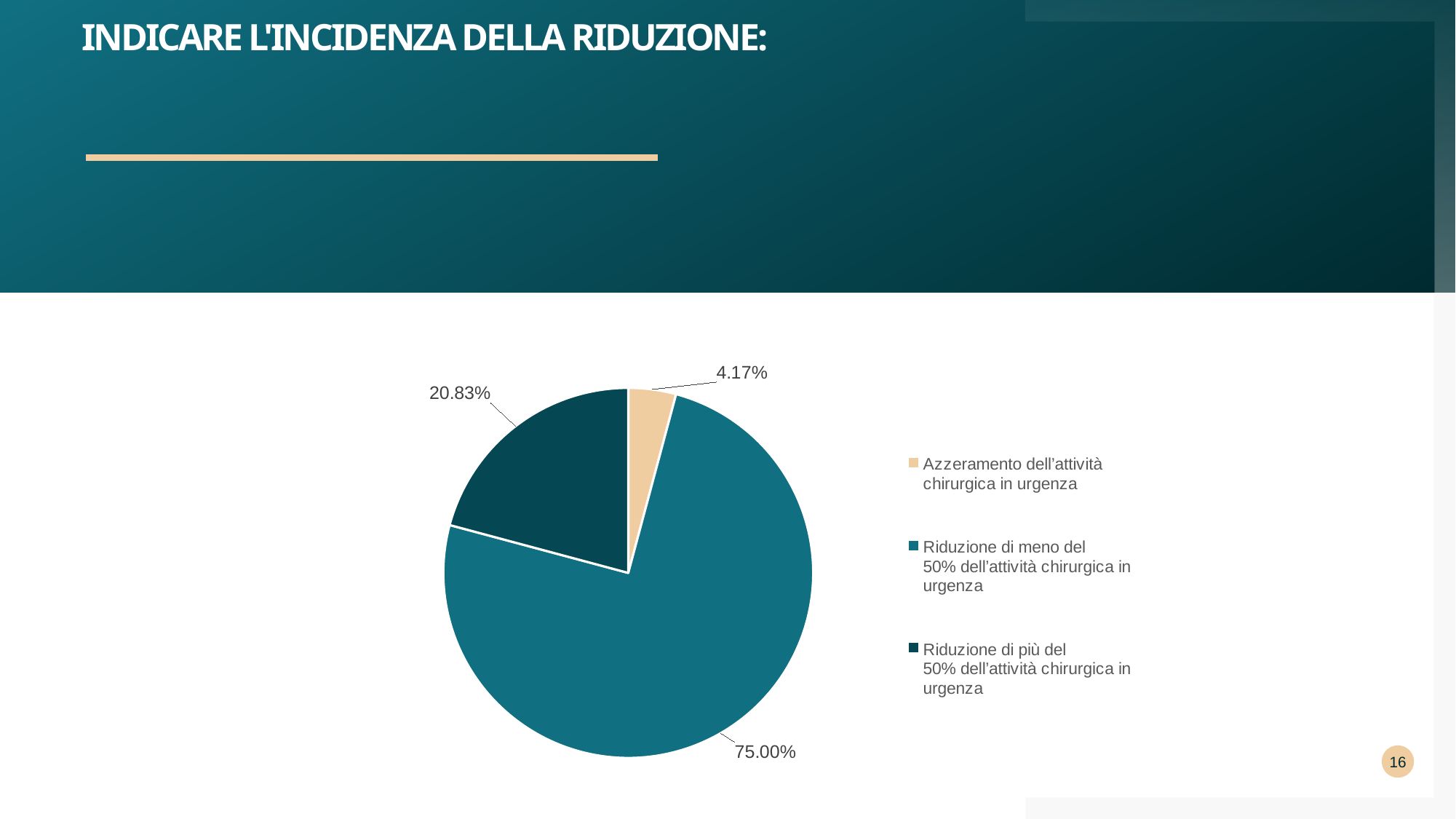
What is the difference in percentage points between 'Riduzione di meno del 50%' and 'Riduzione di più del 50%'? 54.17 How many slices does the pie chart have? 3 What colour is the slice for 'Azzeramento dell'attività chirurgica in urgenza'? beige Which category has the smallest slice of the pie? Azzeramento dell'attività chirurgica in urgenza Which category has the largest slice of the pie? Riduzione di meno del 50% dell'attività chirurgica in urgenza Which is larger: the slice for 'Riduzione di più del 50%' or the slice for 'Azzeramento dell'attività chirurgica in urgenza'? Riduzione di più del 50% dell'attività chirurgica in urgenza What share of the pie is 'Riduzione di meno del 50% dell'attività chirurgica in urgenza'? 75.00% What is the combined share of the two 'Riduzione' slices? 95.83% What share of the pie is 'Riduzione di più del 50% dell'attività chirurgica in urgenza'? 20.83% What is the title of the slide containing the chart? INDICARE L'INCIDENZA DELLA RIDUZIONE: What kind of chart is shown on the slide? pie chart What share of the pie is 'Azzeramento dell'attività chirurgica in urgenza'? 4.17%